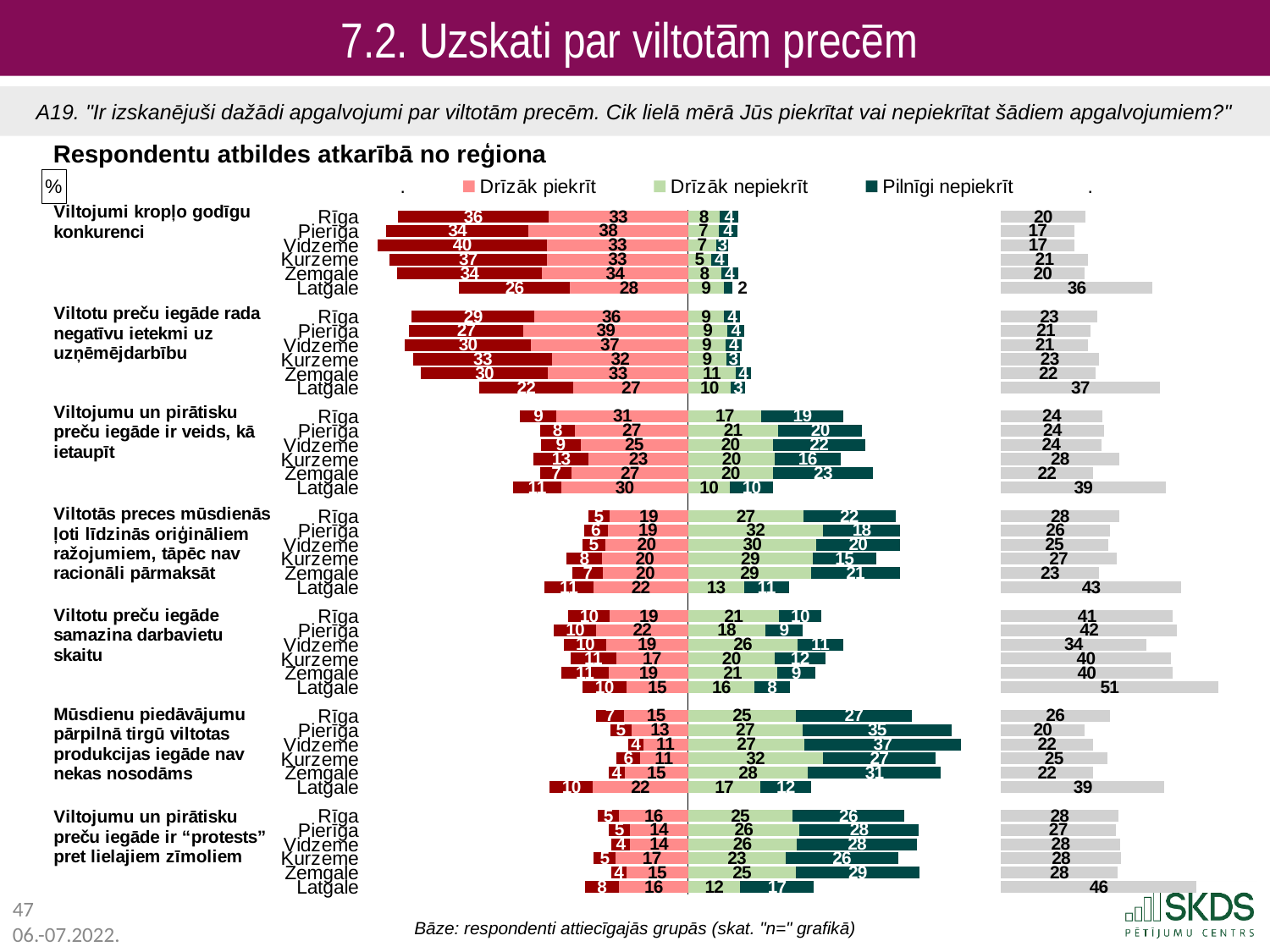
In the statement "Viltojumi kropļo godīgu konkurenci", what is the difference between the "Drīzāk piekrīt" values for Pierīga and Latgale? 10 In the statement "Viltotās preces mūsdienās ļoti līdzinās oriģināliem ražojumiem, tāpēc nav racionāli pārmaksāt", what is the "Drīzāk nepiekrīt" value for Rīga? 27 In the statement "Viltojumi kropļo godīgu konkurenci", what is the "Drīzāk piekrīt" value for Pierīga? 38 How many regions are listed for each statement in the chart? 6 In the statement "Viltojumu un pirātisku preču iegāde ir 'protests' pret lielajiem zīmoliem", which region has the lowest "Pilnīgi nepiekrīt" value? Latgale In the statement "Mūsdienu piedāvājumu pārpilnā tirgū viltotas produkcijas iegāde nav nekas nosodāms", what is the "Pilnīgi nepiekrīt" value for Pierīga? 35 In the statement "Viltojumi kropļo godīgu konkurenci", what is the sum of the "Drīzāk piekrīt" and "Drīzāk nepiekrīt" values for Rīga? 41 In the statement "Viltotu preču iegāde samazina darbavietu skaitu", which region has the highest value in the grey bars on the right? Latgale What is the title of the chart on the slide? Respondentu atbildes atkarībā no reģiona What type of chart is shown on the slide? Bar chart In the statement "Viltotu preču iegāde rada negatīvu ietekmi uz uzņēmējdarbību", which region has the highest "Drīzāk piekrīt" value? Pierīga In the statement "Viltotās preces mūsdienās ļoti līdzinās oriģināliem ražojumiem, tāpēc nav racionāli pārmaksāt", which region has the larger "Drīzāk nepiekrīt" value, Pierīga or Vidzeme? Pierīga